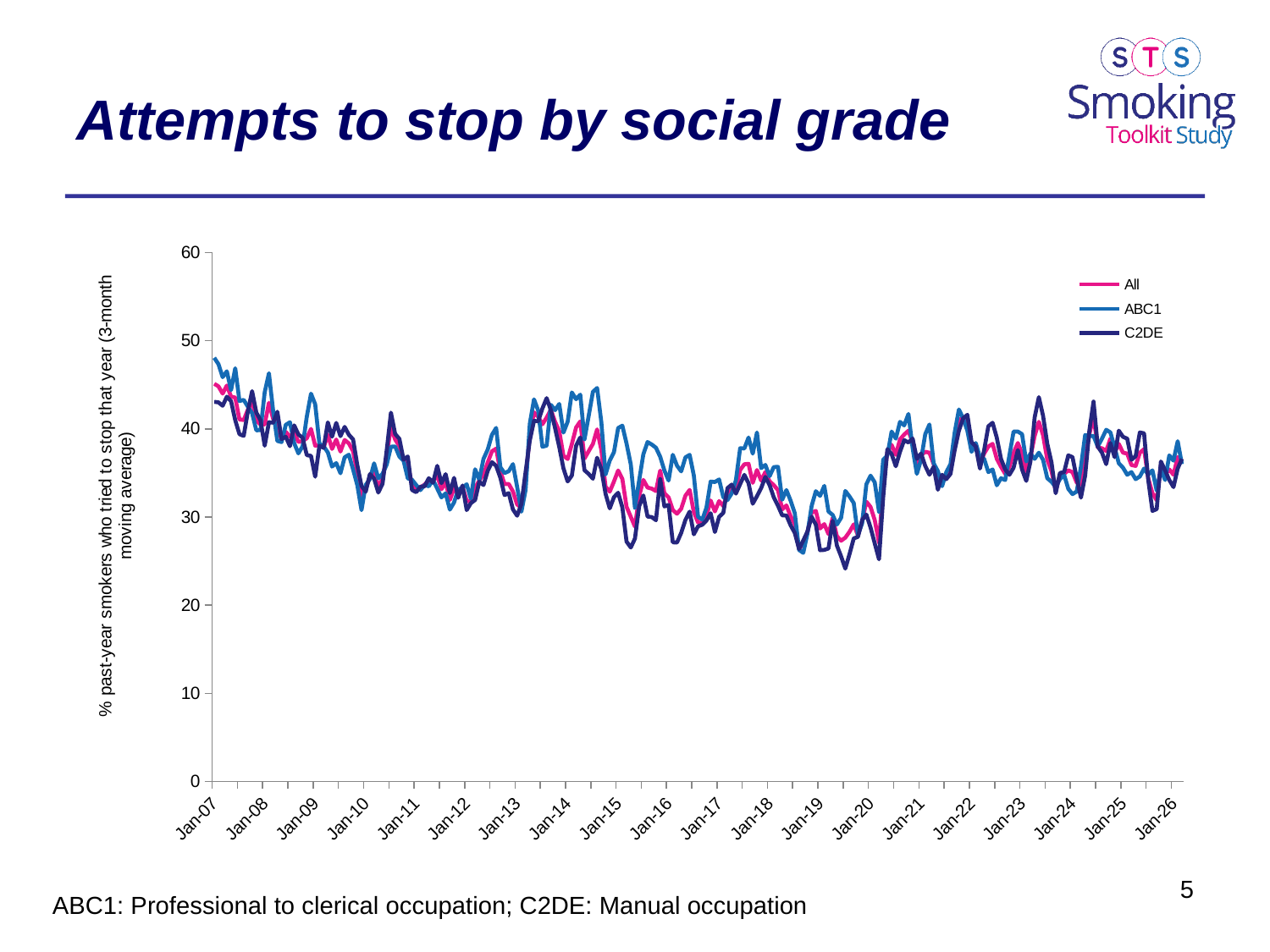
What kind of chart is shown on the slide? line chart Which series has the highest value at Jan-07? ABC1 What are the three series named in the legend? All, ABC1, C2DE Do the values generally rise or fall between Jan-07 and Jan-10? fall Is the value for All at Jan-14 greater or less than 30? greater What is the highest value shown on the y axis? 60 Do the values generally rise or fall between Jan-20 and Jan-21? rise How many series does the legend list? 3 What is the title of the slide's chart? Attempts to stop by social grade Is the value for ABC1 at Jan-07 greater or less than 40? greater How many year labels (Jan-07 to Jan-26) are shown on the x axis? 20 Is the value for C2DE at Jan-20 greater or less than 30? less